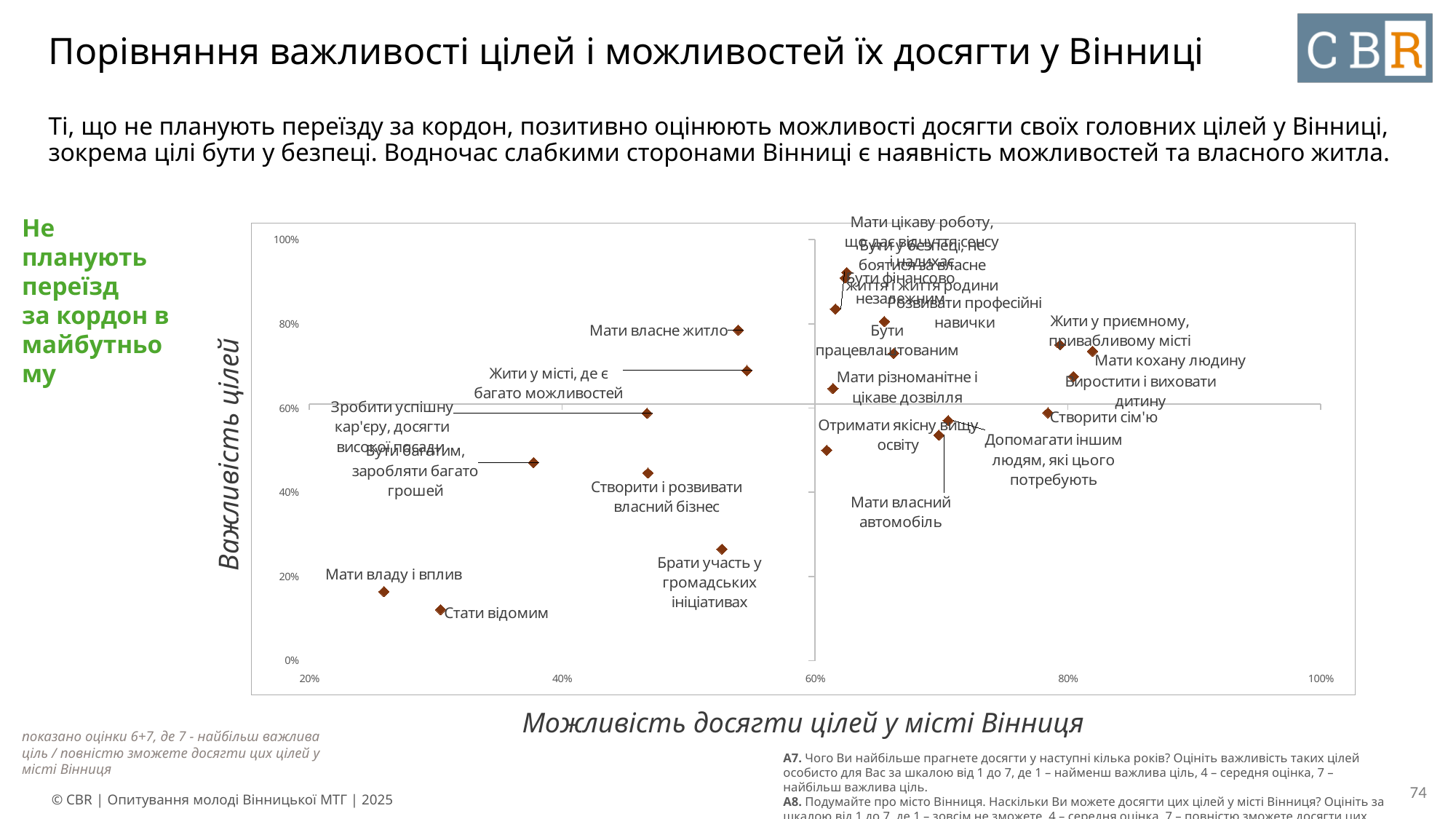
Is the importance (vertical axis) value for "Бути у безпеці" greater or less than 80%? greater What is the title of the horizontal axis of the chart? Можливість досягти цілей у місті Вінниця What kind of chart is shown on the slide? Scatter chart Is the horizontal-axis value for "Мати кохану людину" greater or less than 80%? greater Is the importance (vertical axis) value for "Жити у приємному, привабливому місті" greater or less than 60%? greater What is the title of the vertical axis of the chart? Важливість цілей Which goal has a higher importance (vertical axis) value: "Мати власне житло" or "Брати участь у громадських ініціативах"? Мати власне житло Which goal has a higher horizontal-axis value: "Мати кохану людину" or "Мати владу і вплив"? Мати кохану людину